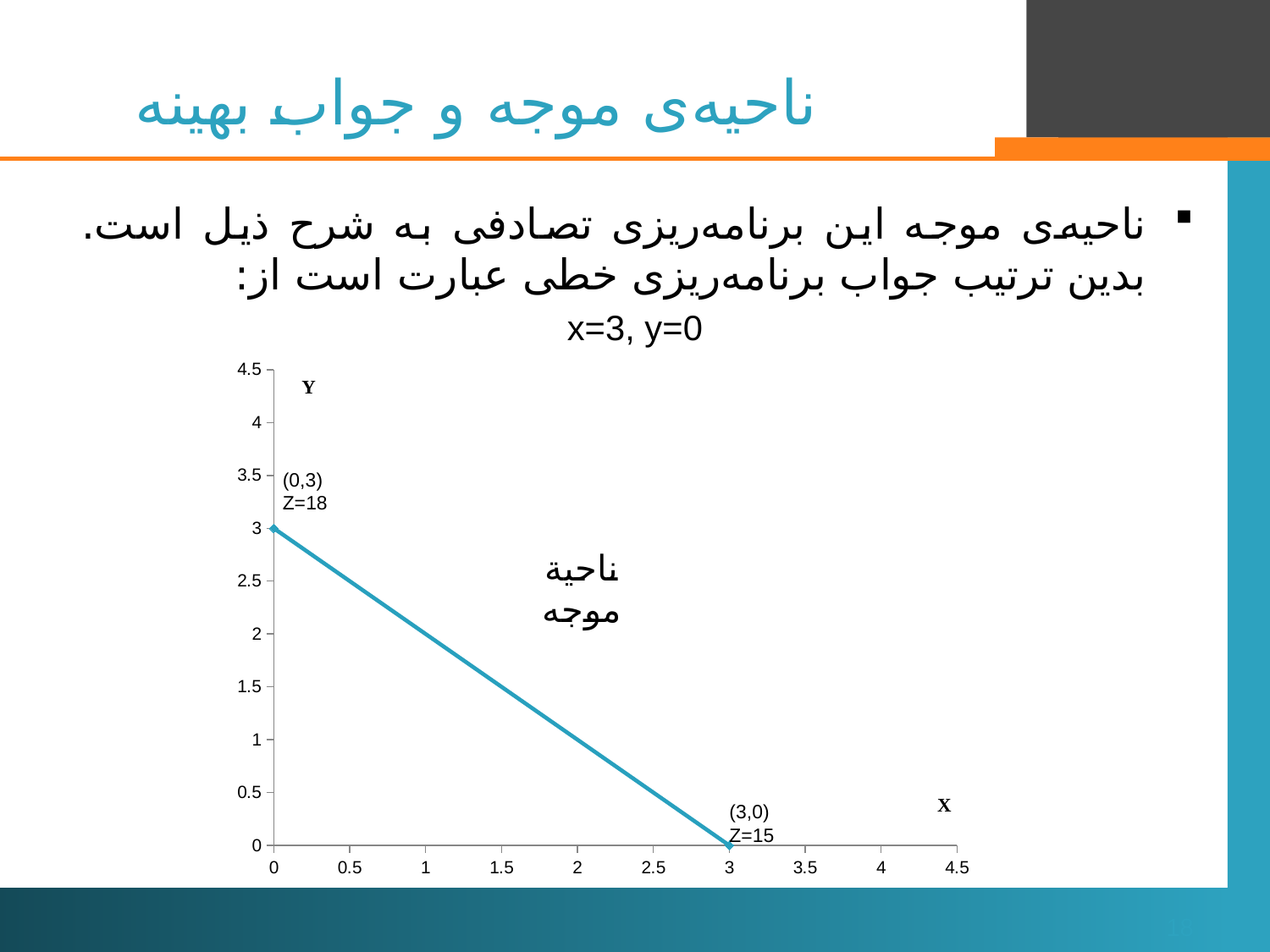
What is the difference between the Z values at (0,3) and (3,0)? 3 Which labelled point has the higher Z value, (0,3) or (3,0)? (0,3) Does the line rise or fall as x increases? fall How many data points are plotted on the line? 2 What is the Z value labelled at the point (0,3)? Z=18 What is the y value of the point where the line meets the y axis? 3 What is the x value of the point where the line meets the x axis? 3 What is the highest value shown on the x axis? 4.5 What is the Z value labelled at the point (3,0)? Z=15 What kind of chart is shown on the slide? line chart Is the y value of the line at x=1.5 greater or less than 2? less What is the highest value shown on the y axis? 4.5